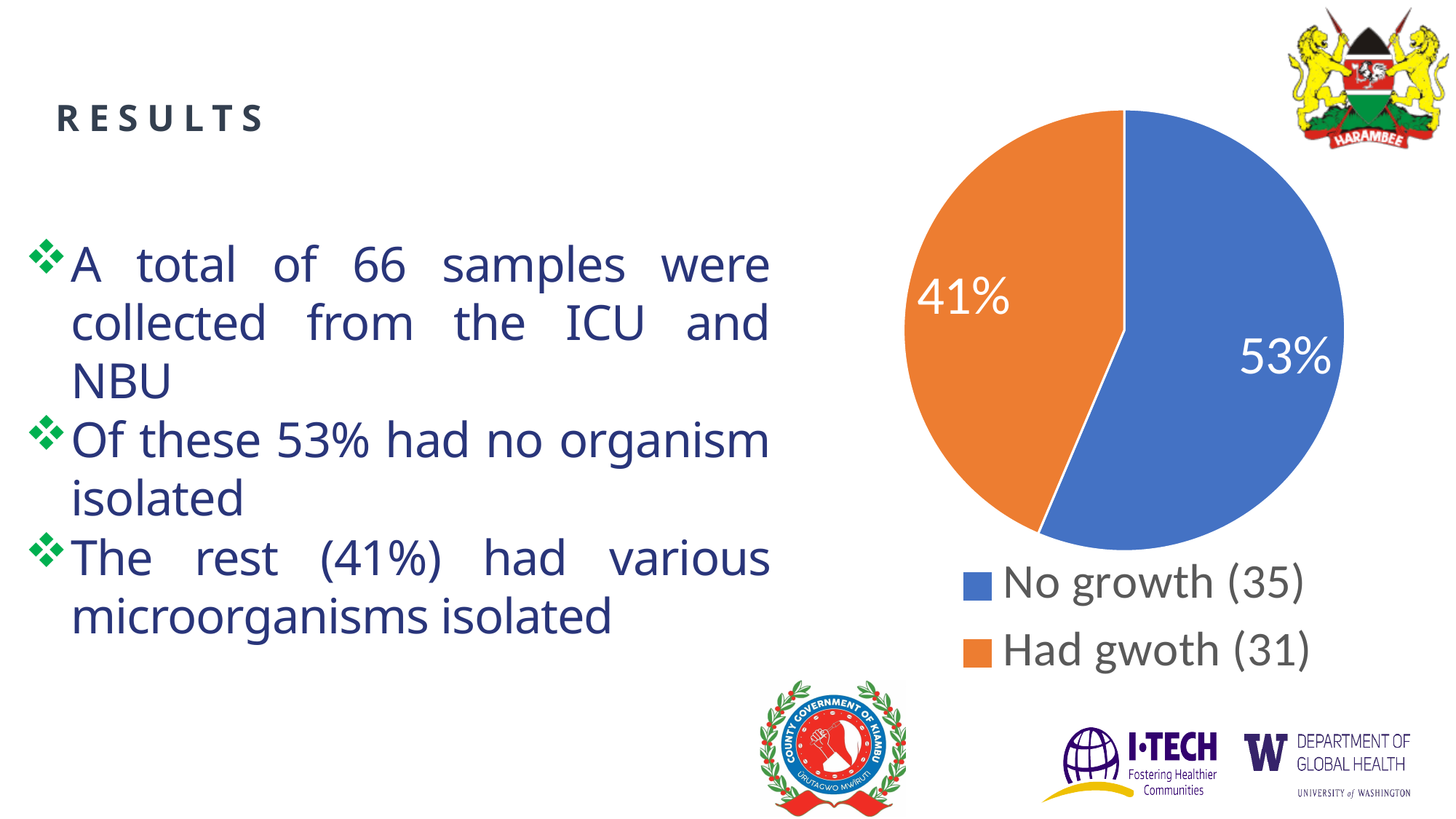
What count is shown in the legend for the No growth category? 35 What count is shown in the legend for the Had gwoth category? 31 What colour is the No growth slice in the pie chart? blue What is the difference in percentage points between the No growth slice and the Had gwoth slice? 12 Which slice of the pie chart is the largest? No growth (35) What kind of chart is shown on the slide? pie chart Which is larger in the pie chart, the No growth slice or the Had gwoth slice? No growth What percentage is shown for the No growth slice of the pie chart? 53% How many slices does the pie chart have? 2 How many entries does the pie chart's legend list? 2 What percentage is shown for the Had gwoth slice of the pie chart? 41% Which slice of the pie chart is the smallest? Had gwoth (31)